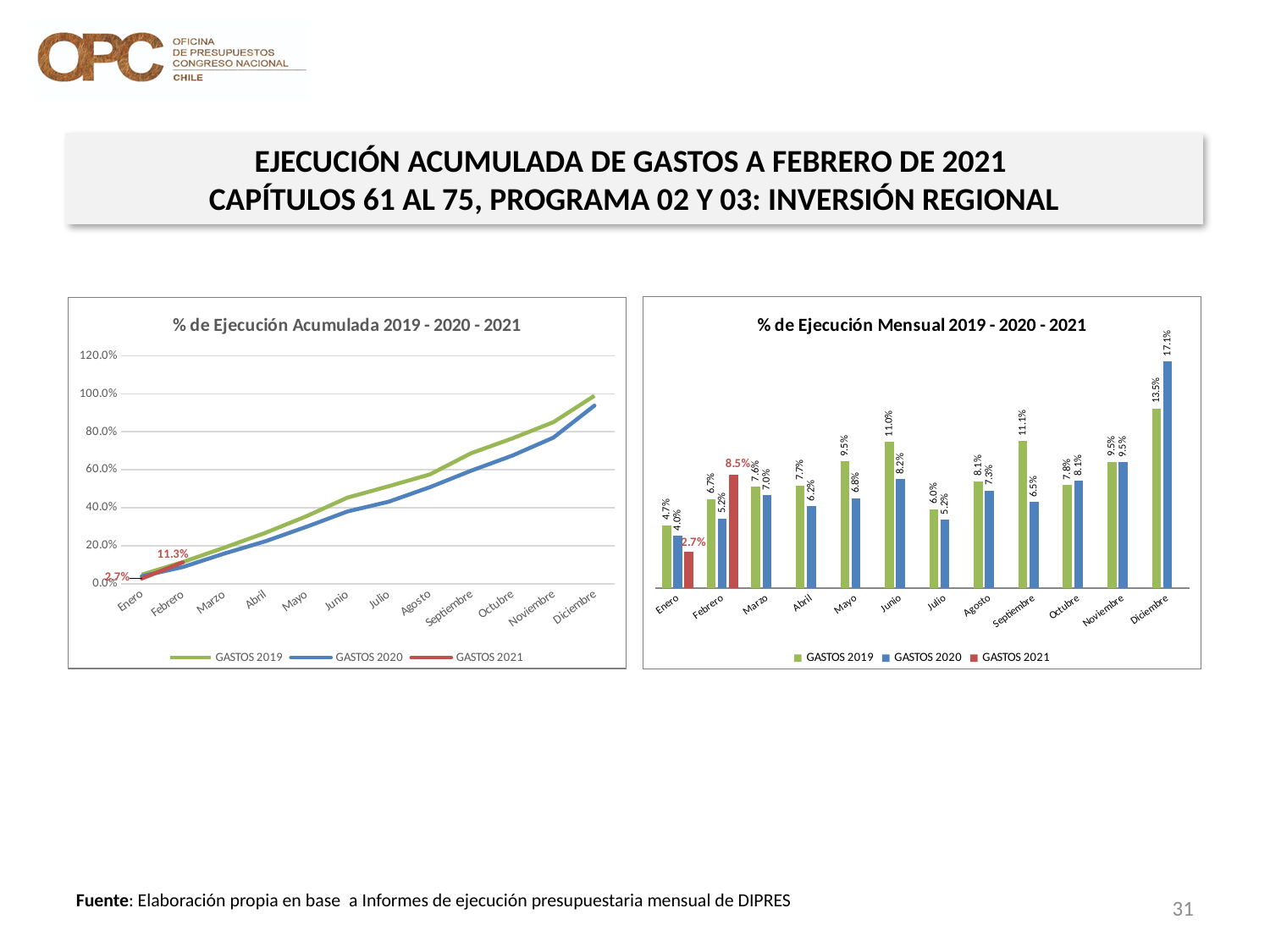
In the chart '% de Ejecución Mensual 2019 - 2020 - 2021', what is the value for GASTOS 2019 in Junio? 11.0% In the chart '% de Ejecución Acumulada 2019 - 2020 - 2021', is the value for GASTOS 2019 in Diciembre greater or less than 80.0%? greater In the chart '% de Ejecución Acumulada 2019 - 2020 - 2021', what is the value for GASTOS 2021 in Febrero? 11.3% In the chart '% de Ejecución Mensual 2019 - 2020 - 2021', what is the value for GASTOS 2021 in Febrero? 8.5% In the chart '% de Ejecución Mensual 2019 - 2020 - 2021', which month has the highest value for GASTOS 2019? Diciembre In the chart '% de Ejecución Mensual 2019 - 2020 - 2021', which month has the lowest value for GASTOS 2020? Enero In the chart '% de Ejecución Mensual 2019 - 2020 - 2021', which is larger in Septiembre: GASTOS 2019 or GASTOS 2020? GASTOS 2019 What kind of chart is '% de Ejecución Acumulada 2019 - 2020 - 2021'? Line chart In the chart '% de Ejecución Mensual 2019 - 2020 - 2021', what is the value for GASTOS 2020 in Diciembre? 17.1% In the chart '% de Ejecución Mensual 2019 - 2020 - 2021', what is the difference between GASTOS 2020 and GASTOS 2019 in Diciembre? 3.6 percentage points How many months are shown on the x axis of the chart '% de Ejecución Mensual 2019 - 2020 - 2021'? 12 How many series does the legend of the chart '% de Ejecución Acumulada 2019 - 2020 - 2021' list? 3